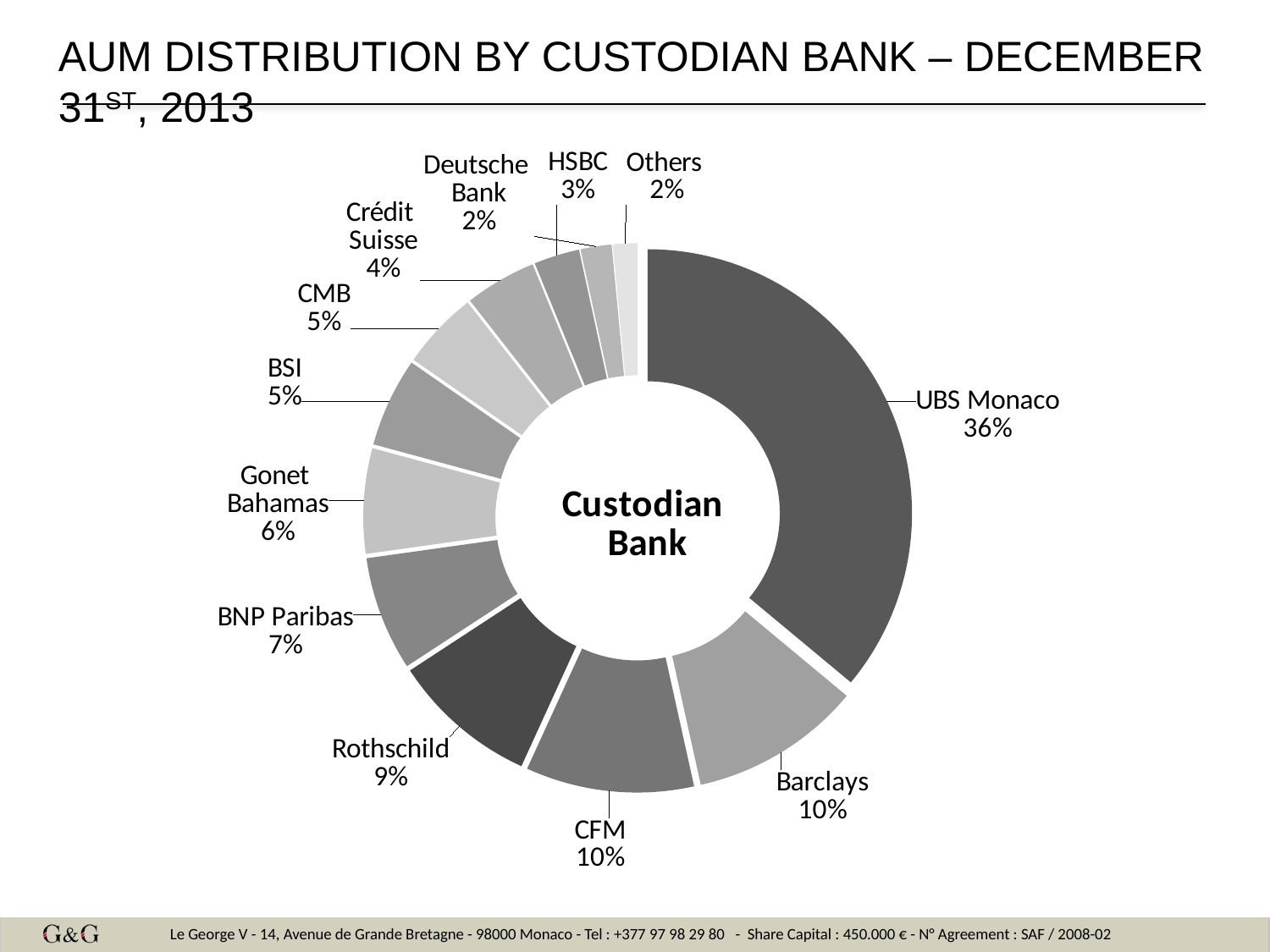
What percentage is shown for Rothschild? 9% What percentage is shown for BNP Paribas? 7% Which has a larger share, BNP Paribas or Gonet Bahamas? BNP Paribas What text appears in the centre of the doughnut chart? Custodian Bank What percentage is shown for HSBC? 3% Which custodian bank has the largest share of AUM? UBS Monaco What is the difference in percentage points between UBS Monaco and Barclays? 26 What kind of chart is shown on the slide? Doughnut (pie) chart How many categories (slices) are shown in the chart? 12 What percentage is shown for Gonet Bahamas? 6% Which has a larger share, Rothschild or Crédit Suisse? Rothschild What share of AUM is held by UBS Monaco? 36%